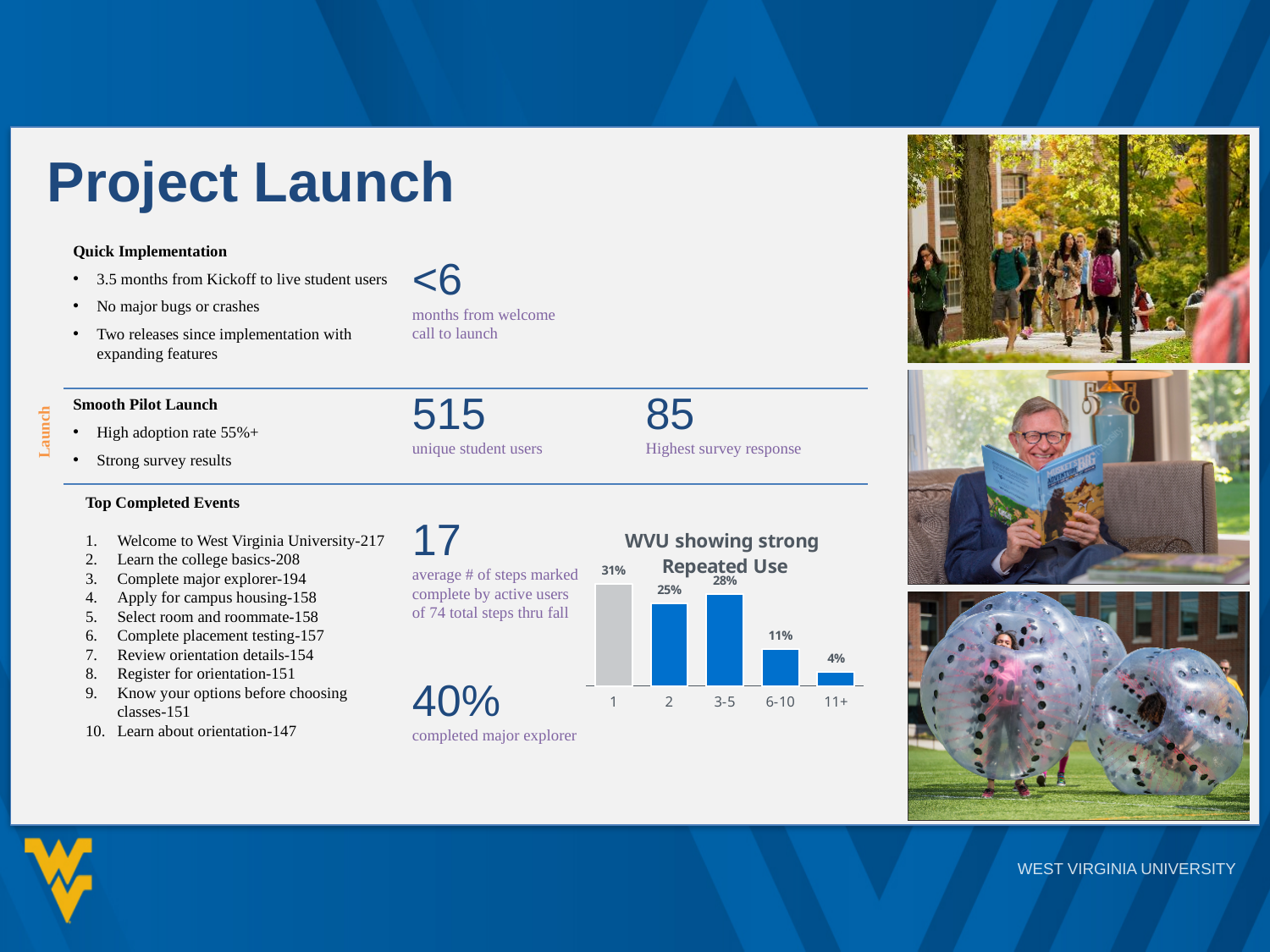
What is the difference between the values for category 3-5 and category 6-10? 17% Which is larger, the value for category 2 or the value for category 3-5? 3-5 What is the title of the chart? WVU showing strong Repeated Use How many categories are shown on the x axis of the chart? 5 What is the value for category 3-5 in the chart? 28% What is the value for category 6-10 in the chart? 11% What type of chart is shown on the slide? bar chart What is the value for category 1 in the chart? 31% What is the value for category 2 in the chart? 25% Which category has the lowest value in the chart? 11+ What is the value for category 11+ in the chart? 4% Which category has the highest value in the chart? 1